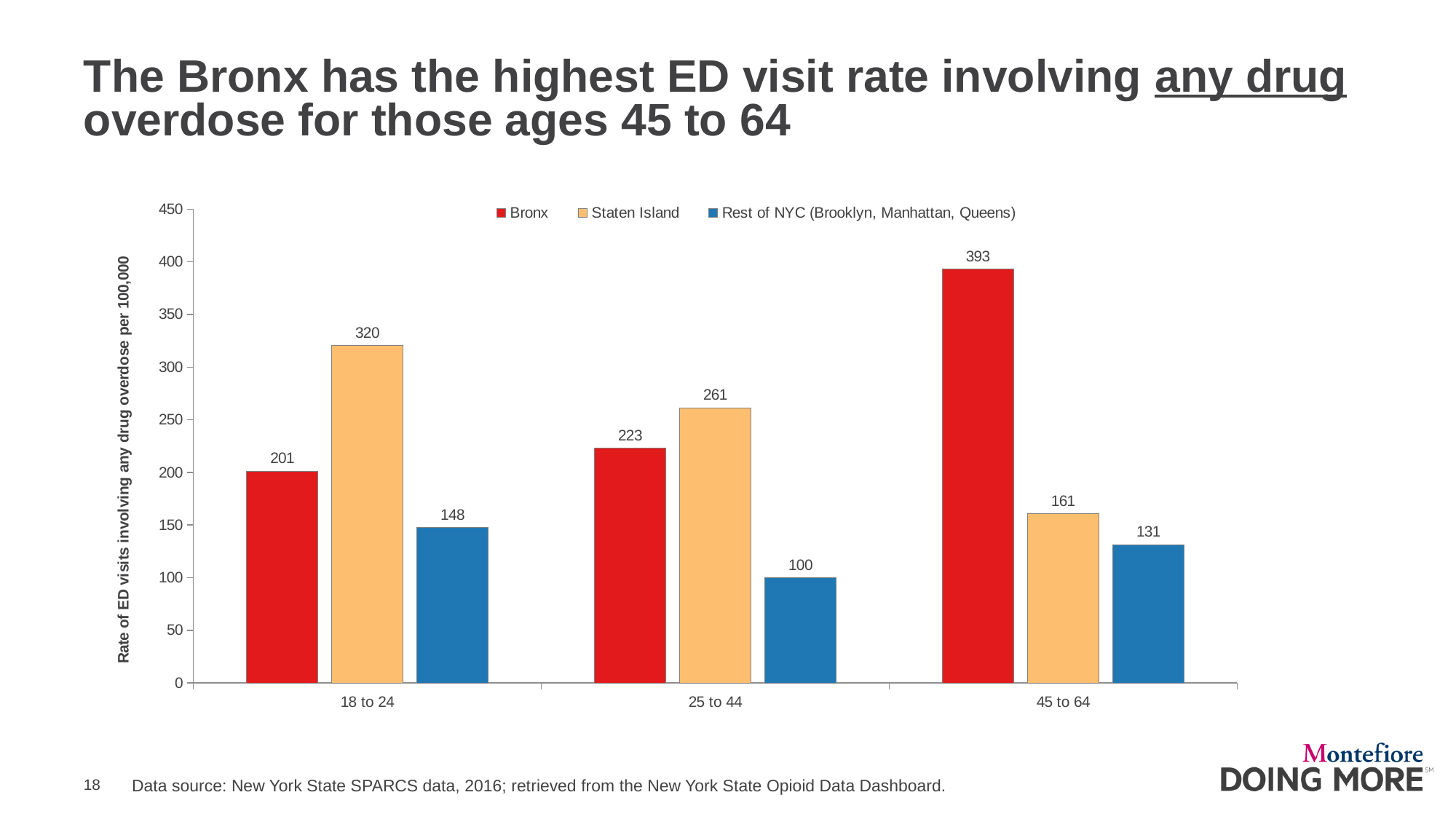
What is the difference between the Bronx and Staten Island ED visit rates in the 45 to 64 age group? 232 What kind of chart is shown on the slide? Bar chart Is the value for Rest of NYC in the 18 to 24 age group greater or less than 200? less What is the ED visit rate for Staten Island in the 18 to 24 age group? 320 Which age group has the highest ED visit rate for the Bronx? 45 to 64 How many series does the legend list? 3 Do the Bronx values rise or fall across the age groups from 18 to 24 to 45 to 64? Rise How many age groups are shown on the x axis? 3 Which series has the lowest ED visit rate in the 45 to 64 age group? Rest of NYC (Brooklyn, Manhattan, Queens) What is the ED visit rate for Rest of NYC (Brooklyn, Manhattan, Queens) in the 25 to 44 age group? 100 What is the ED visit rate for the Bronx in the 45 to 64 age group? 393 Which is larger in the 25 to 44 age group, the Bronx rate or the Staten Island rate? Staten Island